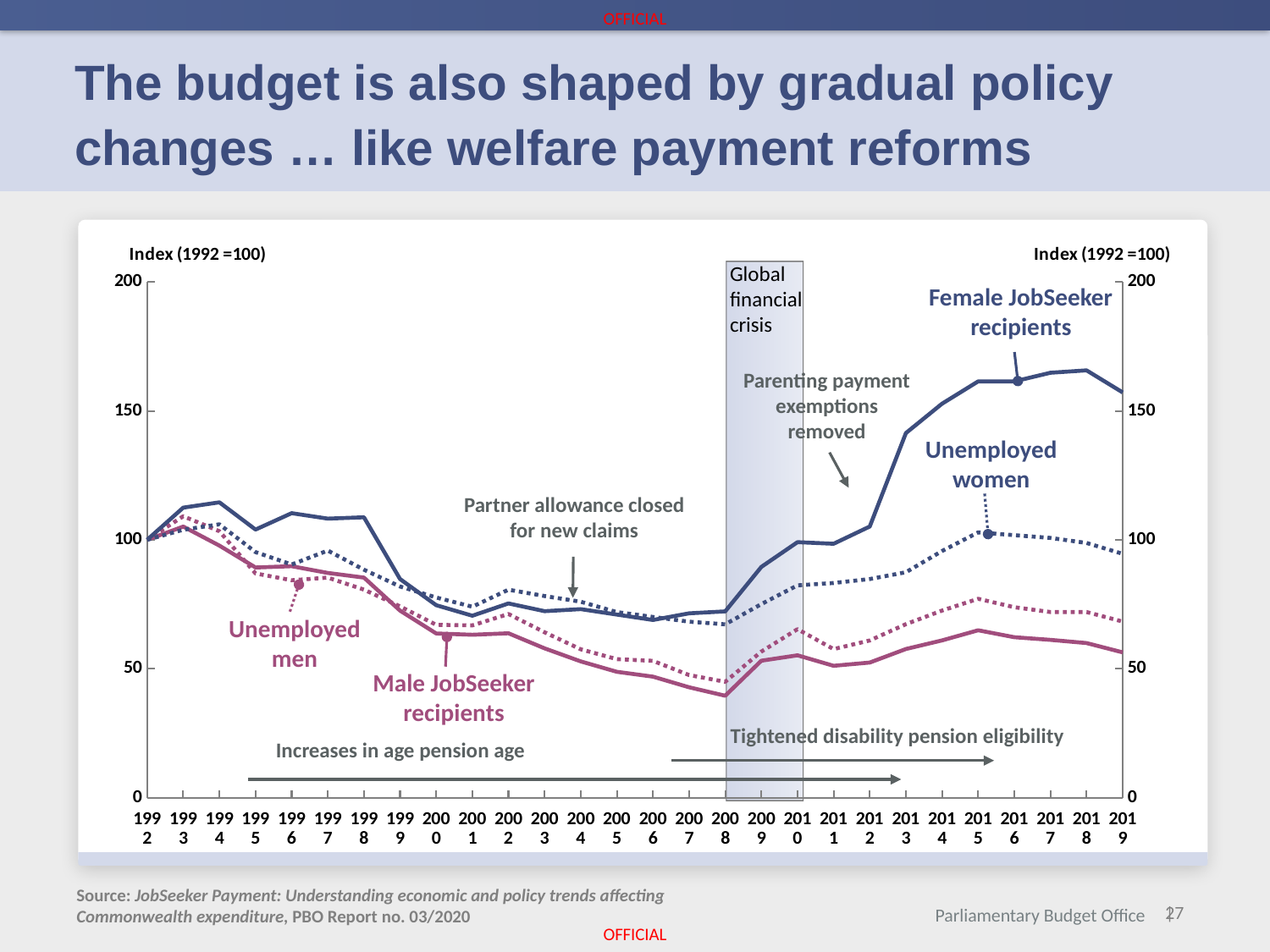
What kind of chart is shown on the slide? line chart Which series has the lowest value in 2019? Male JobSeeker recipients How many years are shown on the x axis? 28 Do the values for Male JobSeeker recipients rise or fall from 1992 to 2008? fall Is the value for Female JobSeeker recipients in 2019 greater or less than 150? greater What event does the shaded vertical band on the chart mark? Global financial crisis How many series are plotted on the chart? 4 Is the value for Unemployed men in 2015 greater or less than 100? less What is the index value of all four series in 1992? 100 Is the value for Male JobSeeker recipients in 2008 greater or less than 50? less In 2008, which is higher: Unemployed women or Unemployed men? Unemployed women Which series has the highest value in 2019? Female JobSeeker recipients